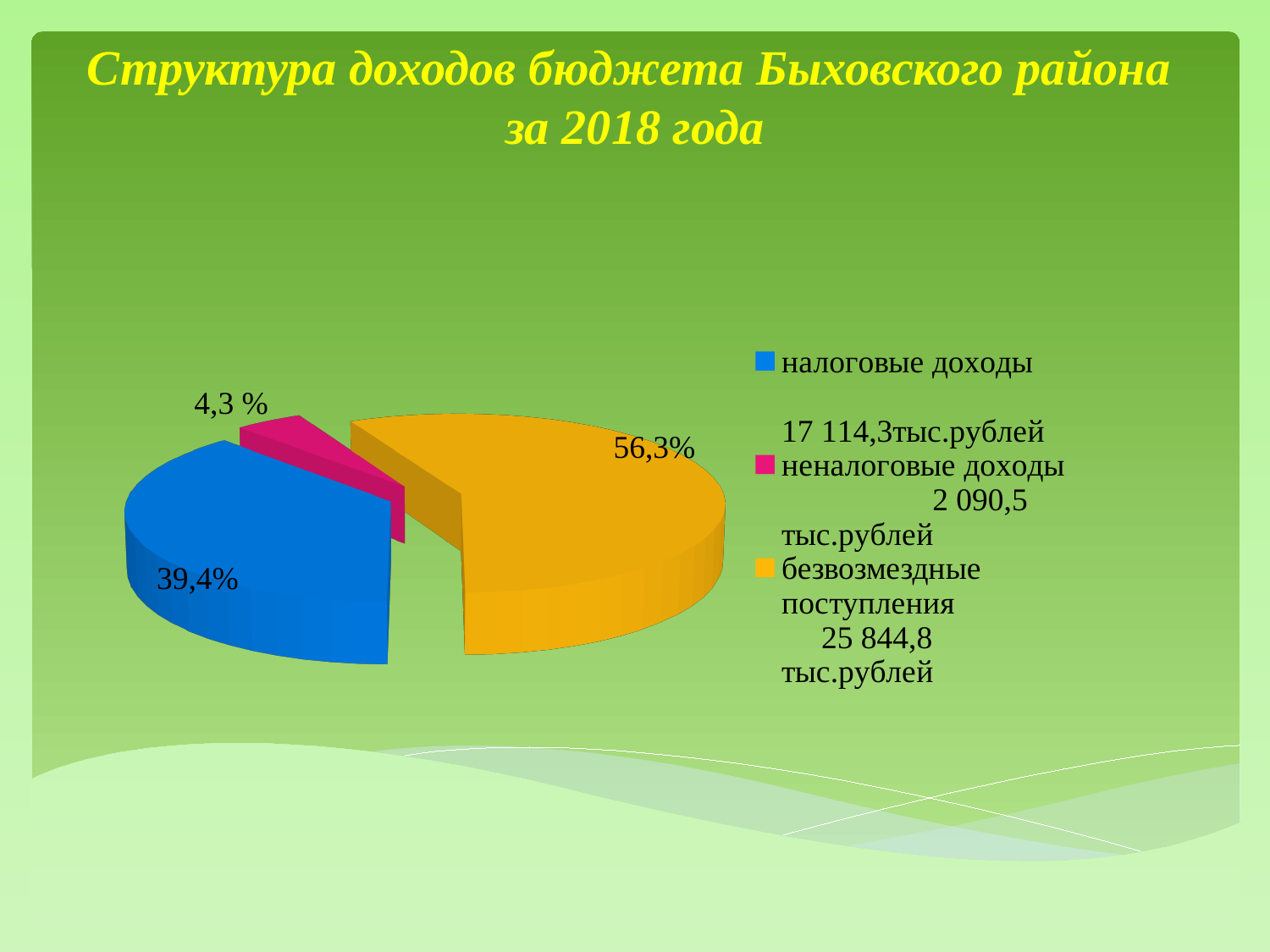
What percentage share is shown for неналоговые доходы? 4,3 % Which category has the largest share of the pie? безвозмездные поступления What colour is the slice for неналоговые доходы? pink What is the difference in percentage points between the share for безвозмездные поступления and the share for налоговые доходы? 16,9 Which is larger: the share for налоговые доходы or the share for безвозмездные поступления? безвозмездные поступления How many entries does the legend list? 3 What is the title of the chart on the slide? Структура доходов бюджета Быховского района за 2018 года What type of chart is shown on the slide? pie chart Which category has the smallest share of the pie? неналоговые доходы What percentage share is shown for безвозмездные поступления? 56,3% How many slices does the pie chart have? 3 What percentage share is shown for налоговые доходы? 39,4%